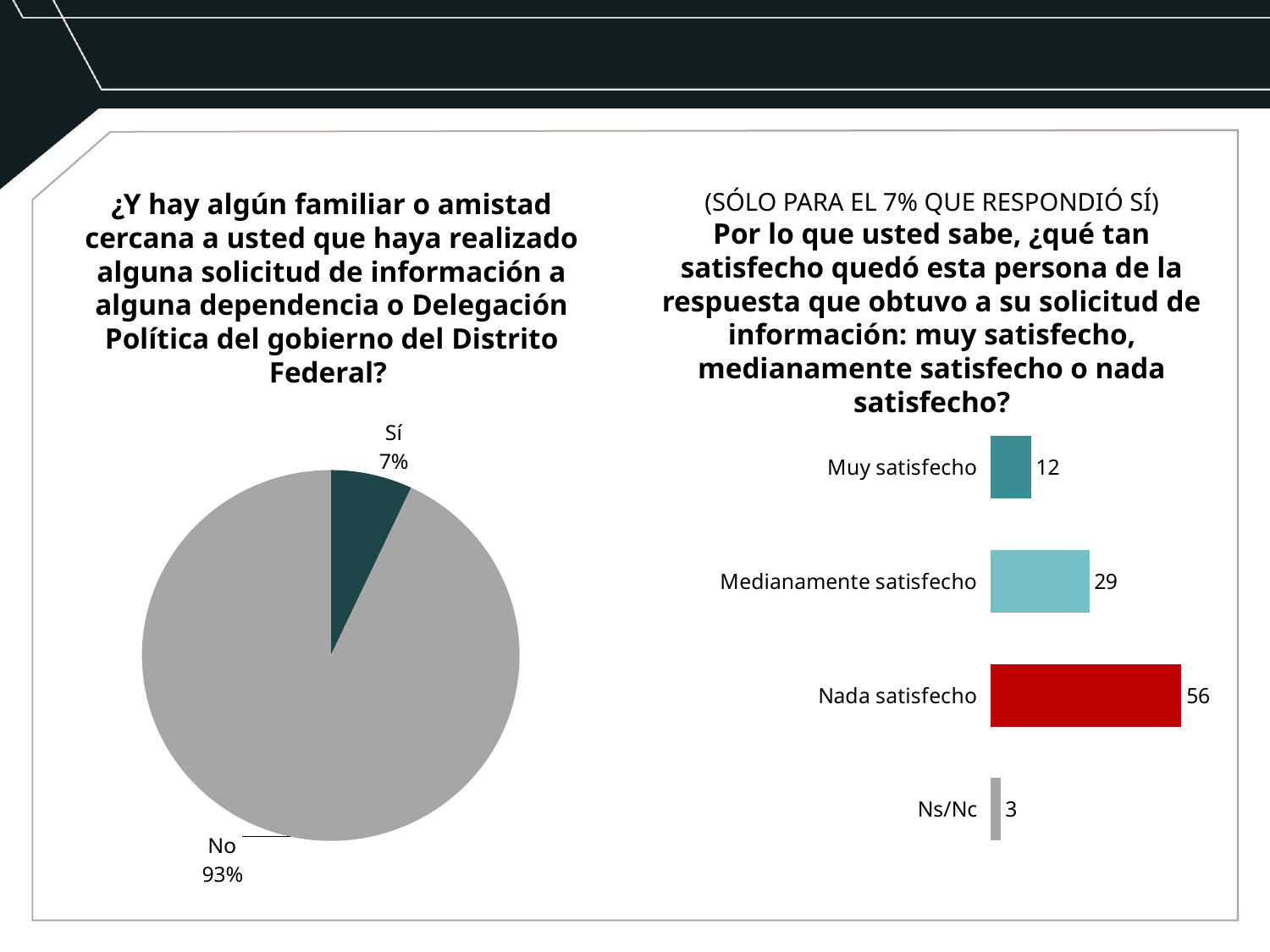
In the pie chart on the left, what percentage answered "No"? 93% What kind of chart is the chart on the left? Pie chart In the bar chart on the right, which category has the lowest value? Ns/Nc In the bar chart on the right, what is the difference between "Nada satisfecho" and "Medianamente satisfecho"? 27 In the bar chart on the right, what is the value for "Nada satisfecho"? 56 In the pie chart on the left, how many slices are there? 2 In the bar chart on the right, how many categories are shown? 4 In the bar chart on the right, which is larger, "Muy satisfecho" or "Medianamente satisfecho"? Medianamente satisfecho In the bar chart on the right, what is the value for "Medianamente satisfecho"? 29 In the bar chart on the right, what is the value for "Muy satisfecho"? 12 In the pie chart on the left, what percentage answered "Sí"? 7% In the pie chart on the left, which category has the largest slice? No